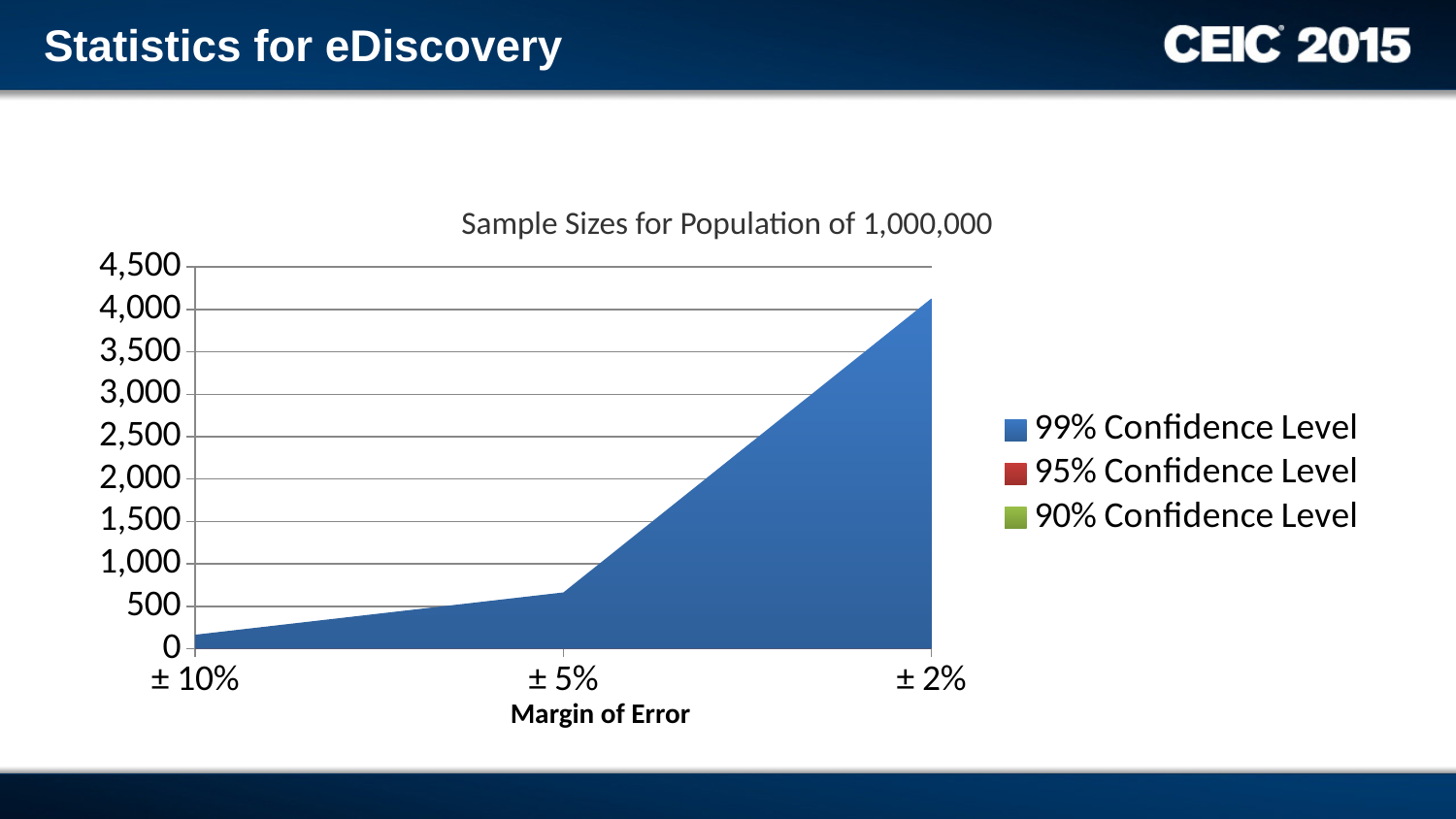
Is the 99% Confidence Level sample size at ± 5% greater or less than 1,000? less Which margin of error has the highest sample size for the 99% Confidence Level? ± 2% Is the 99% Confidence Level sample size at ± 2% greater or less than 3,500? greater Is the 99% Confidence Level sample size at ± 10% greater or less than 500? less Which margin of error has the lowest sample size for the 99% Confidence Level? ± 10% What is the title of the chart? Sample Sizes for Population of 1,000,000 Which is larger for the 99% Confidence Level: the sample size at ± 5% or at ± 2%? ± 2% How many margin-of-error categories are shown on the x axis? 3 How many series does the legend list? 3 What type of chart is shown on the slide? Area chart Do the 99% Confidence Level sample sizes rise or fall moving from ± 10% to ± 2% along the x axis? Rise What is the label of the x axis? Margin of Error